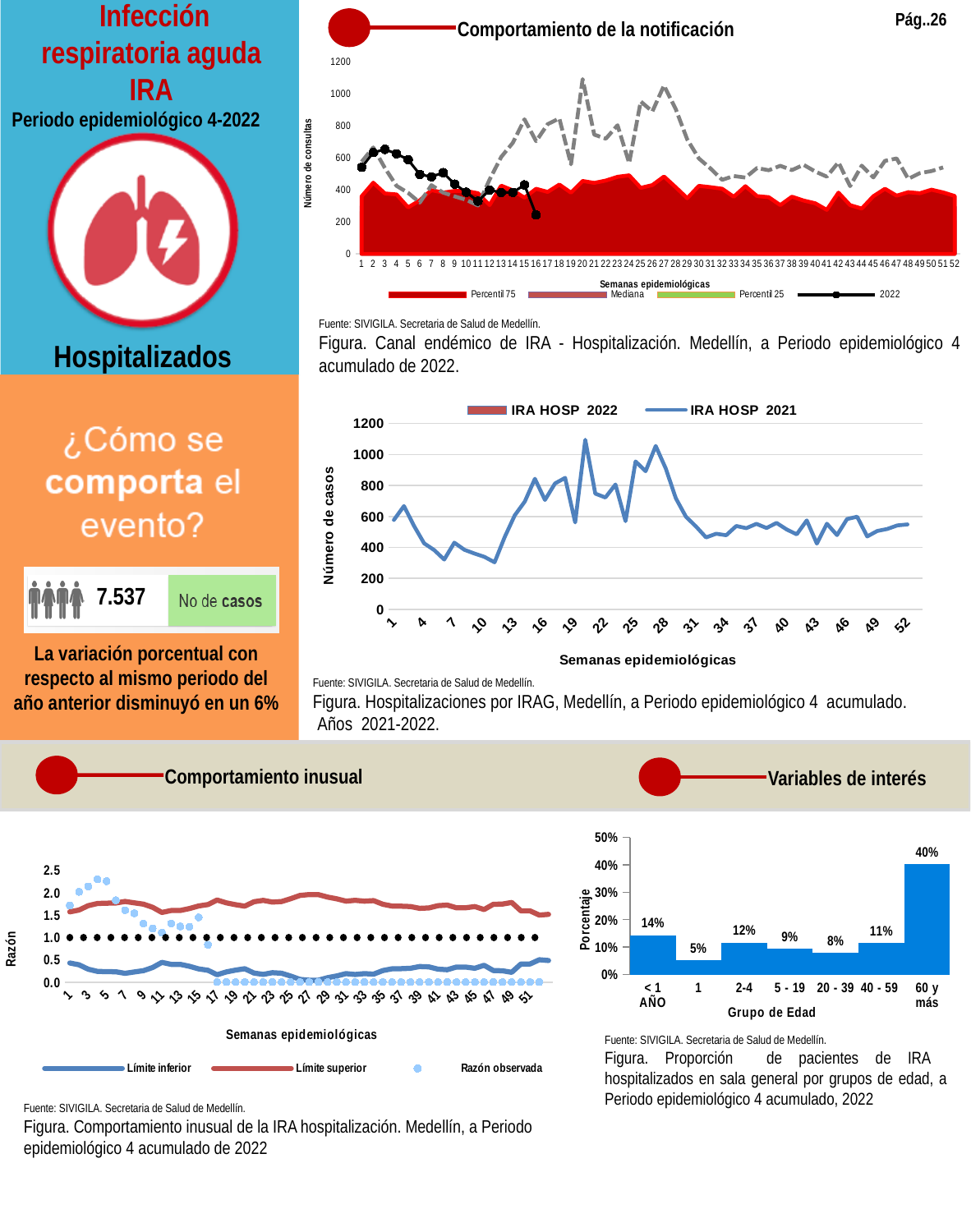
How many age groups are shown in the bar chart at the bottom right? 7 In the 'Comportamiento inusual' chart at the bottom left, how many series does the legend list? 3 In the bar chart by age group (bottom right), what is the difference between the '60 y más' group and the '< 1 AÑO' group? 26 percentage points How many series does the legend list in the 'Comportamiento de la notificación' endemic channel chart at the top right? 4 In the bar chart by age group (bottom right), which is larger: the value for '2-4' or the value for '40 - 59'? 2-4 In the bar chart by age group (bottom right), what is the value for the '< 1 AÑO' group? 14% In the bar chart by age group (bottom right), which age group has the lowest percentage? 1 What kind of chart is the 'Grupo de Edad' chart at the bottom right? Bar chart In the 'IRA HOSP' chart in the middle right, is the value of the IRA HOSP 2021 line at week 10 greater or less than 400? less How many series does the legend list in the 'IRA HOSP 2022 / IRA HOSP 2021' chart in the middle right? 2 In the bar chart by age group (bottom right), which age group has the highest percentage? 60 y más In the bar chart of the proportion of IRA hospitalized patients by age group (bottom right), what is the value for the '60 y más' group? 40%